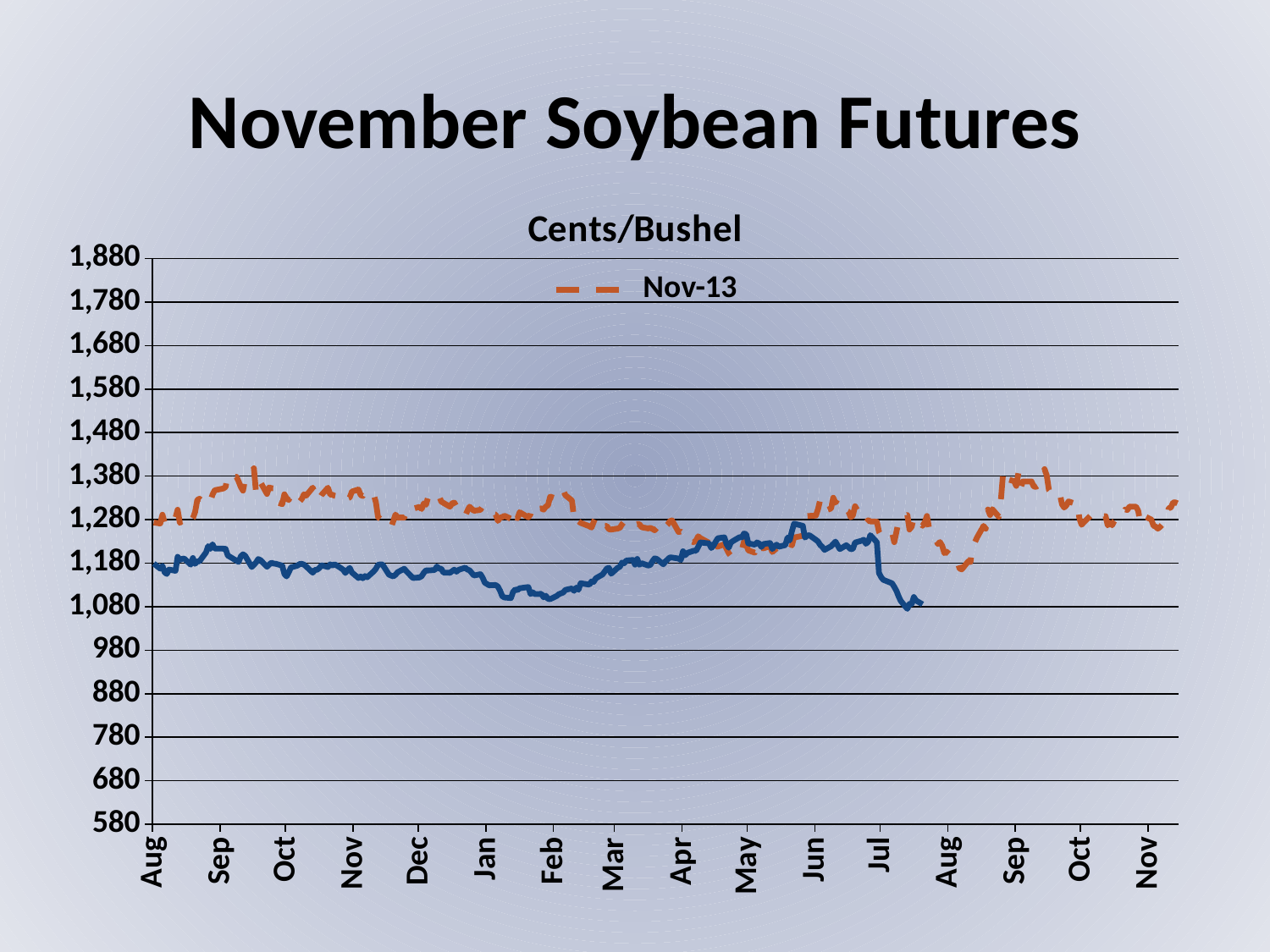
What is the title of the chart? Cents/Bushel Is the value of the solid blue line at Jun greater or less than 1,080? greater How many month labels are shown along the x axis? 16 Does the Nov-13 series rise or fall between the second Aug and the second Sep? rise What kind of chart is shown on the slide? line chart Is the value of the Nov-13 series at the second Aug greater or less than 1,280? less What series name appears in the legend? Nov-13 Is the value of the Nov-13 series at Sep (the first Sep) greater or less than 1,280? greater Does the solid blue line rise or fall between Jun and Jul? fall How many series does the legend list? 1 Which line is higher at Dec, the Nov-13 dashed line or the solid blue line? Nov-13 dashed line